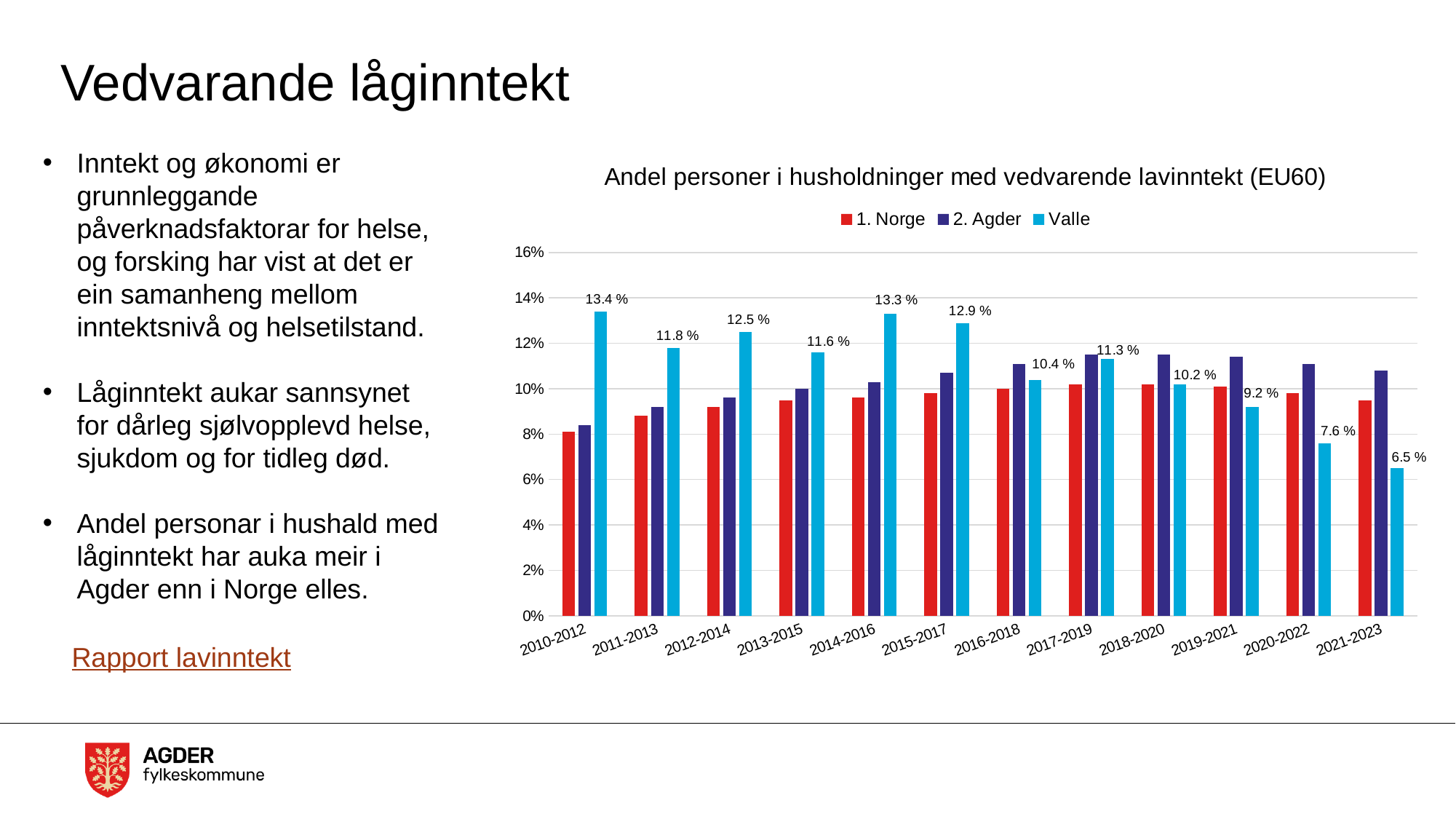
Is the value for 2. Agder in 2021-2023 greater or less than 10%? greater What is the difference between the Valle values in 2010-2012 and 2021-2023? 6.9 % In which period is the Valle value highest? 2010-2012 Which is larger for Valle: the value in 2014-2016 or in 2015-2017? 2014-2016 How many periods are shown on the x axis? 12 Is the value for 1. Norge in 2010-2012 greater or less than 10%? less What is the value for Valle in 2010-2012? 13.4 % What is the value for Valle in 2016-2018? 10.4 % How many series does the legend list? 3 What is the value for Valle in 2021-2023? 6.5 % What kind of chart is shown on the slide? Bar chart In which period is the Valle value lowest? 2021-2023